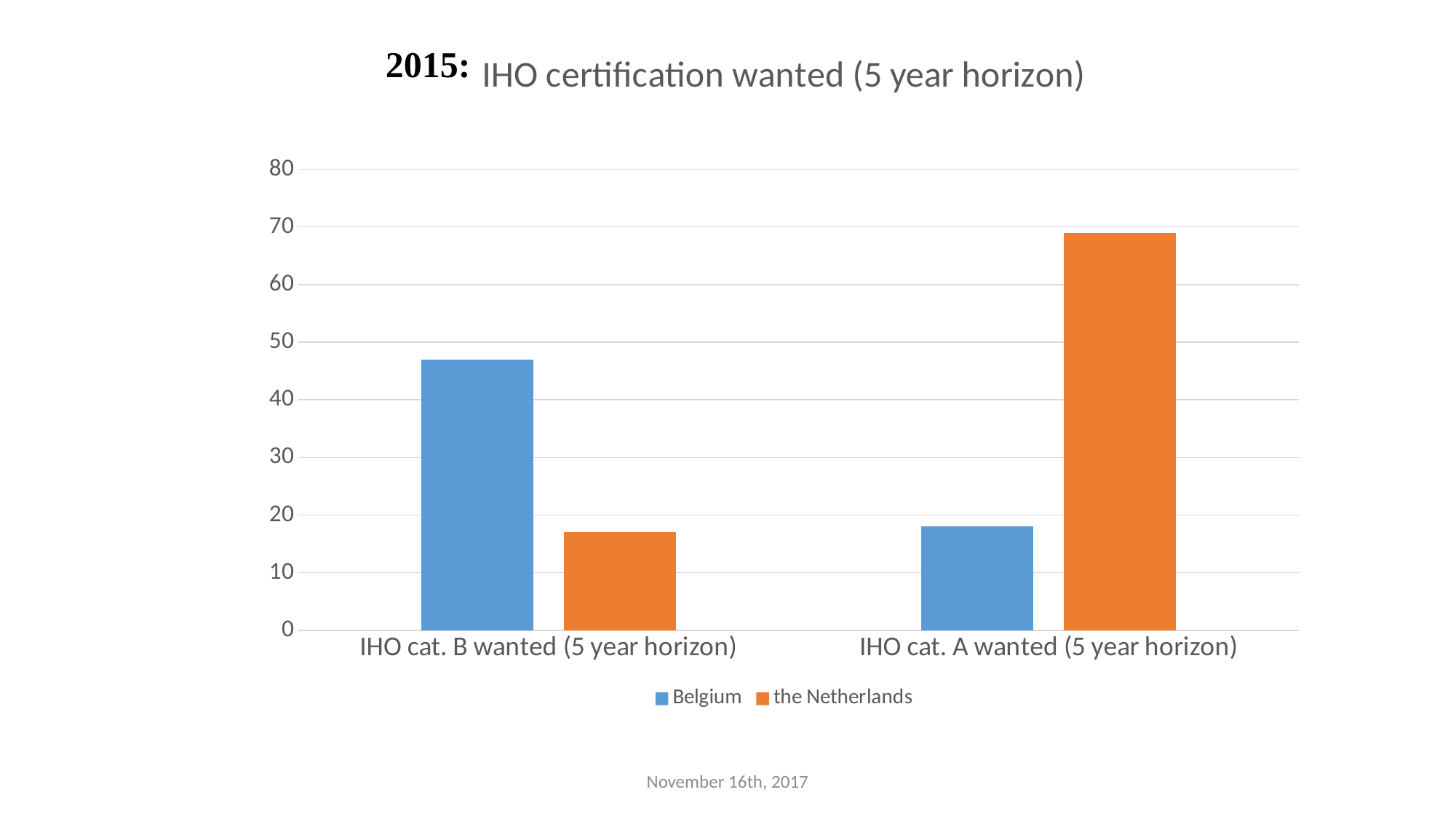
Is the value for Belgium in 'IHO cat. B wanted (5 year horizon)' greater or less than 50? less What is the title of the chart? IHO certification wanted (5 year horizon) How many categories are shown on the x axis? 2 Is the value for the Netherlands in 'IHO cat. B wanted (5 year horizon)' greater or less than 20? less Is the value for Belgium in 'IHO cat. B wanted (5 year horizon)' greater or less than 40? greater Which bar is the highest in the chart? the Netherlands, IHO cat. A wanted (5 year horizon) For 'IHO cat. B wanted (5 year horizon)', which series has the larger value, Belgium or the Netherlands? Belgium Which series is shown in orange? the Netherlands How many series does the legend list? 2 For 'IHO cat. A wanted (5 year horizon)', which series has the larger value, Belgium or the Netherlands? the Netherlands What kind of chart is shown on the slide? bar chart